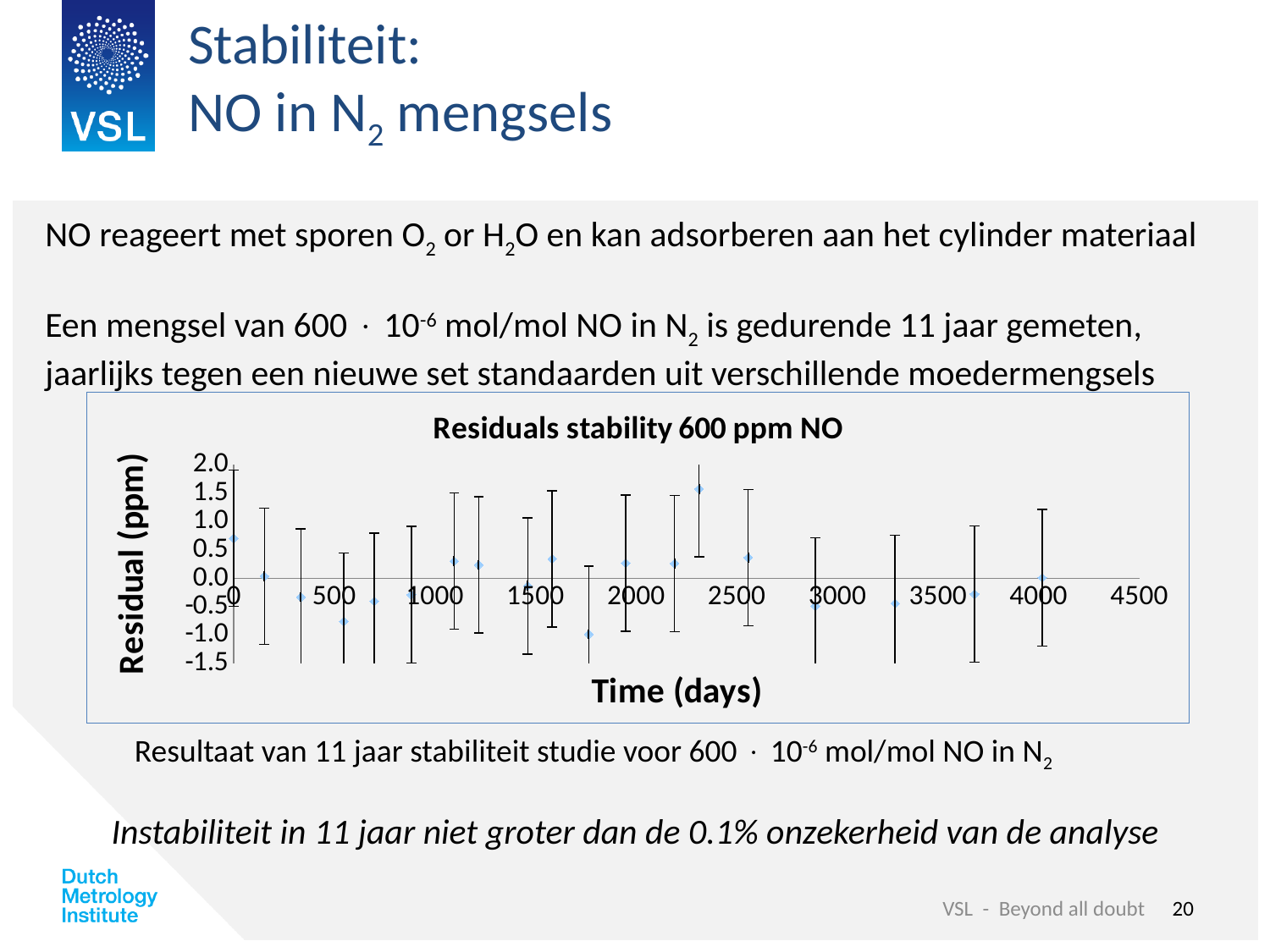
What is the largest tick value shown on the horizontal axis (Time in days)? 4500 What is the title of the chart? Residuals stability 600 ppm NO Is the residual for the point plotted near 2300 days greater or less than 1.0 ppm? greater What kind of chart is shown on the slide? Scatter chart Is the residual for the first point (at 0 days) greater or less than 0.5 ppm? greater What is the lowest value shown on the vertical axis of the chart? -1.5 What is the highest value shown on the vertical axis of the chart? 2.0 What is the label of the vertical axis of the chart? Residual (ppm) Which has the larger residual: the point near 2300 days or the point near 1750 days? The point near 2300 days Is the residual for the point plotted near 1750 days greater or less than -0.5 ppm? less